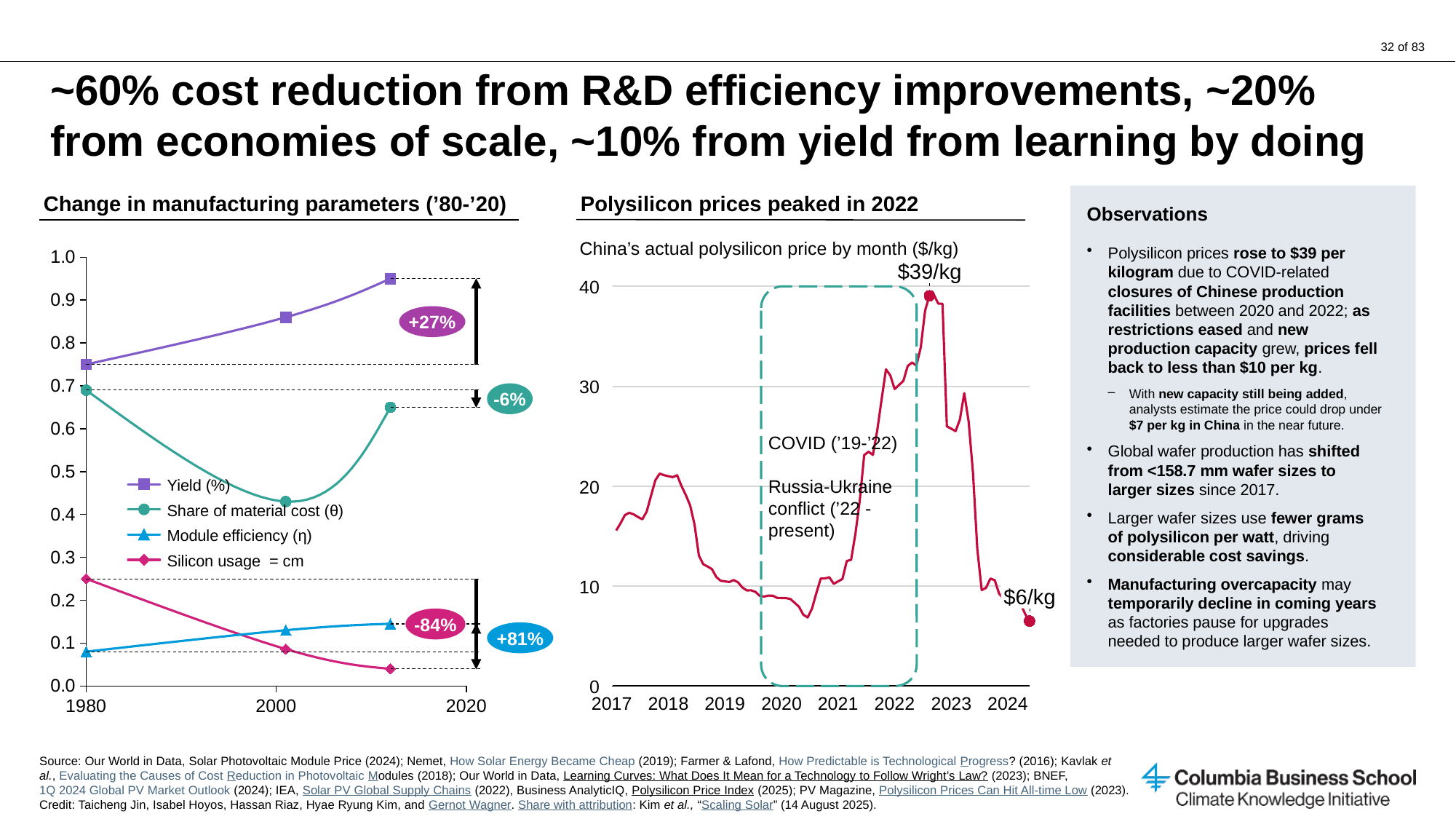
In 'Change in manufacturing parameters ('80-'20)', what percentage change is annotated for Silicon usage? -84% In 'Polysilicon prices peaked in 2022', what peak price is labelled on the chart? $39/kg In 'Change in manufacturing parameters ('80-'20)', is the value for Yield (%) in 2020 greater or less than 0.9? greater In 'Change in manufacturing parameters ('80-'20)', what percentage change is annotated for Share of material cost (θ)? -6% What kind of chart is 'Change in manufacturing parameters ('80-'20)'? line chart In 'Change in manufacturing parameters ('80-'20)', what percentage change is annotated for Yield (%)? +27% In 'Polysilicon prices peaked in 2022', does the price rise or fall from its 2022 peak to 2024? fall In 'Change in manufacturing parameters ('80-'20)', what percentage change is annotated for Module efficiency (η)? +81% In 'Change in manufacturing parameters ('80-'20)', which is higher in 2020: Yield (%) or Share of material cost (θ)? Yield (%) In 'Change in manufacturing parameters ('80-'20)', is the value for Silicon usage in 1980 greater or less than 0.2? greater In 'Polysilicon prices peaked in 2022', what price is labelled at the end of the line in 2024? $6/kg How many series does the legend of 'Change in manufacturing parameters ('80-'20)' list? 4